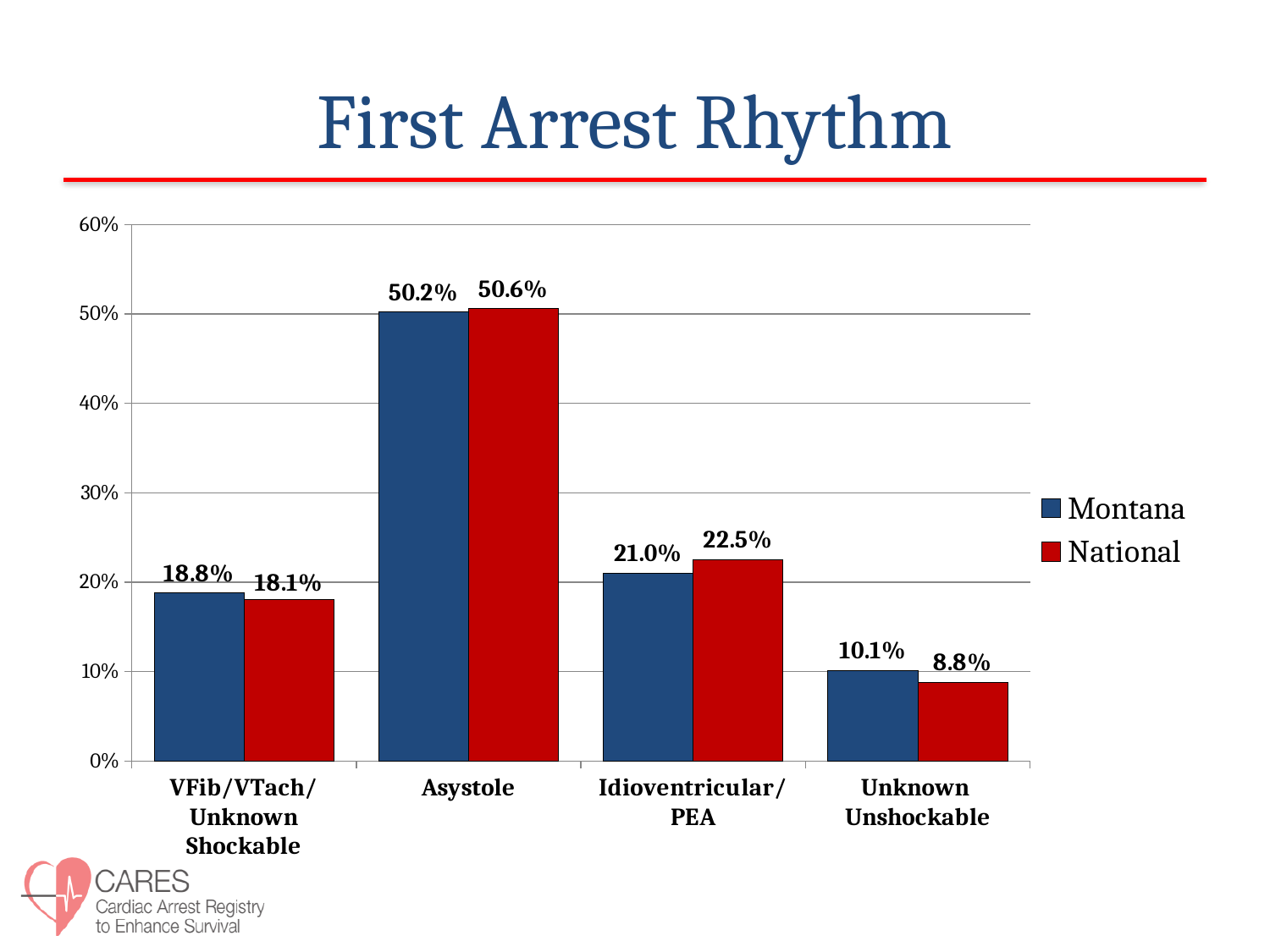
Which category has the lowest National value? Unknown Unshockable What is the title of the chart? First Arrest Rhythm What is the difference between the National and Montana values for Idioventricular/PEA? 1.5% What is the National value for Idioventricular/PEA? 22.5% Which is larger for Unknown Unshockable, the Montana value or the National value? Montana What is the Montana value for Unknown Unshockable? 10.1% What is the National value for VFib/VTach/Unknown Shockable? 18.1% How many series does the legend list? 2 Which category has the highest Montana value? Asystole What kind of chart is shown on the slide? Bar chart What is the Montana value for Asystole? 50.2% How many categories are shown on the x axis? 4